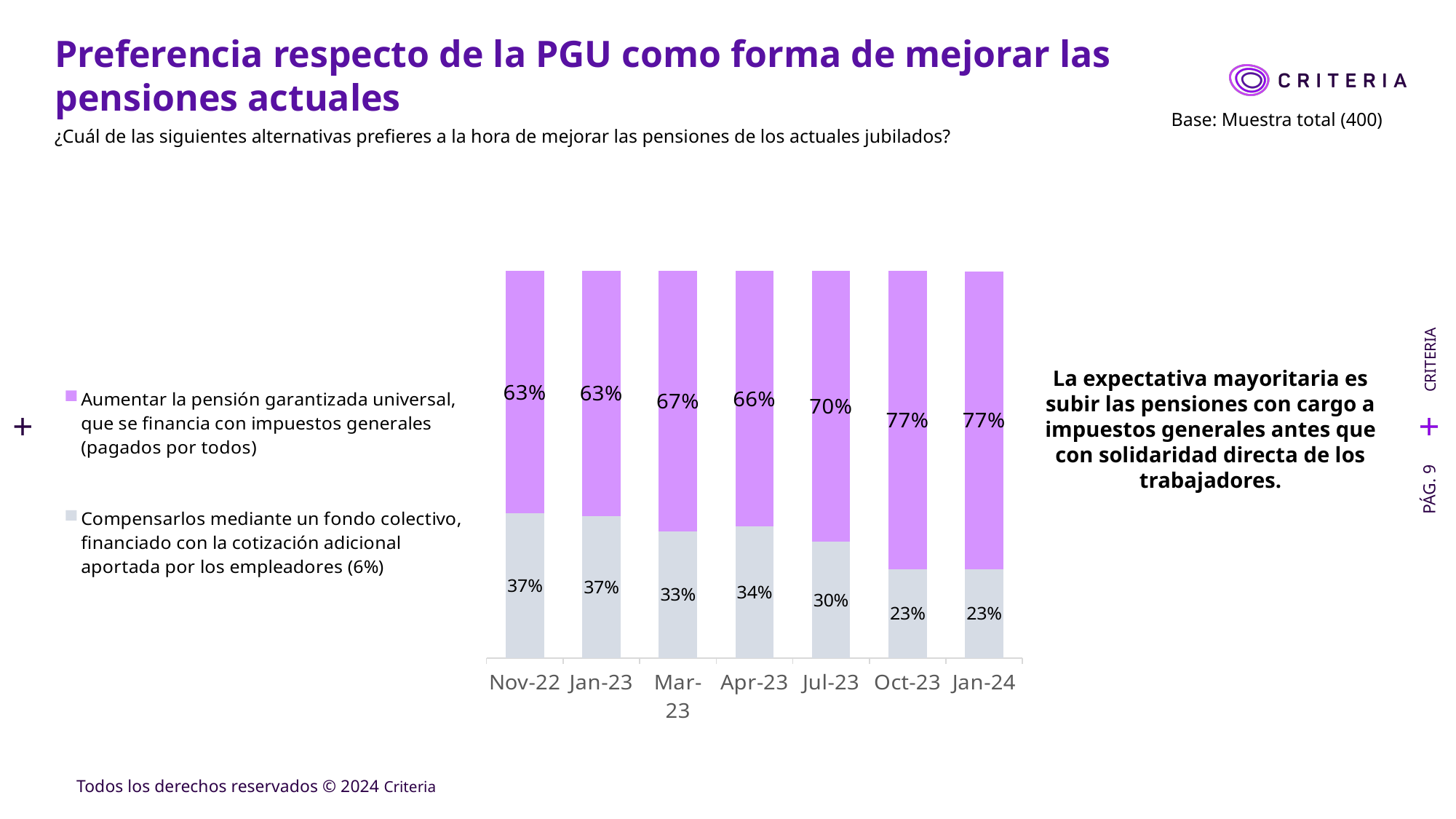
How many series does the legend list? 2 In which period was the share preferring the PGU option lowest? Nov-22 and Jan-23 (63%) How many time periods are shown on the x axis? 7 Which is larger in Mar-23: the PGU share or the collective fund share? The PGU share (67%) What is the value for the PGU option in Jul-23? 70% In which period was the share preferring the collective fund option lowest? Oct-23 and Jan-24 (23%) What is the difference between the PGU share in Jan-24 and in Nov-22? 14 percentage points Does the share preferring the PGU option rise or fall from Nov-22 to Jan-24? Rise What percentage preferred increasing the universal guaranteed pension (PGU) in Jan-24? 77% What is the total of the stacked bar for Apr-23? 100% What percentage preferred compensating via a collective fund financed by employer contributions in Nov-22? 37% What kind of chart is shown? Stacked bar chart